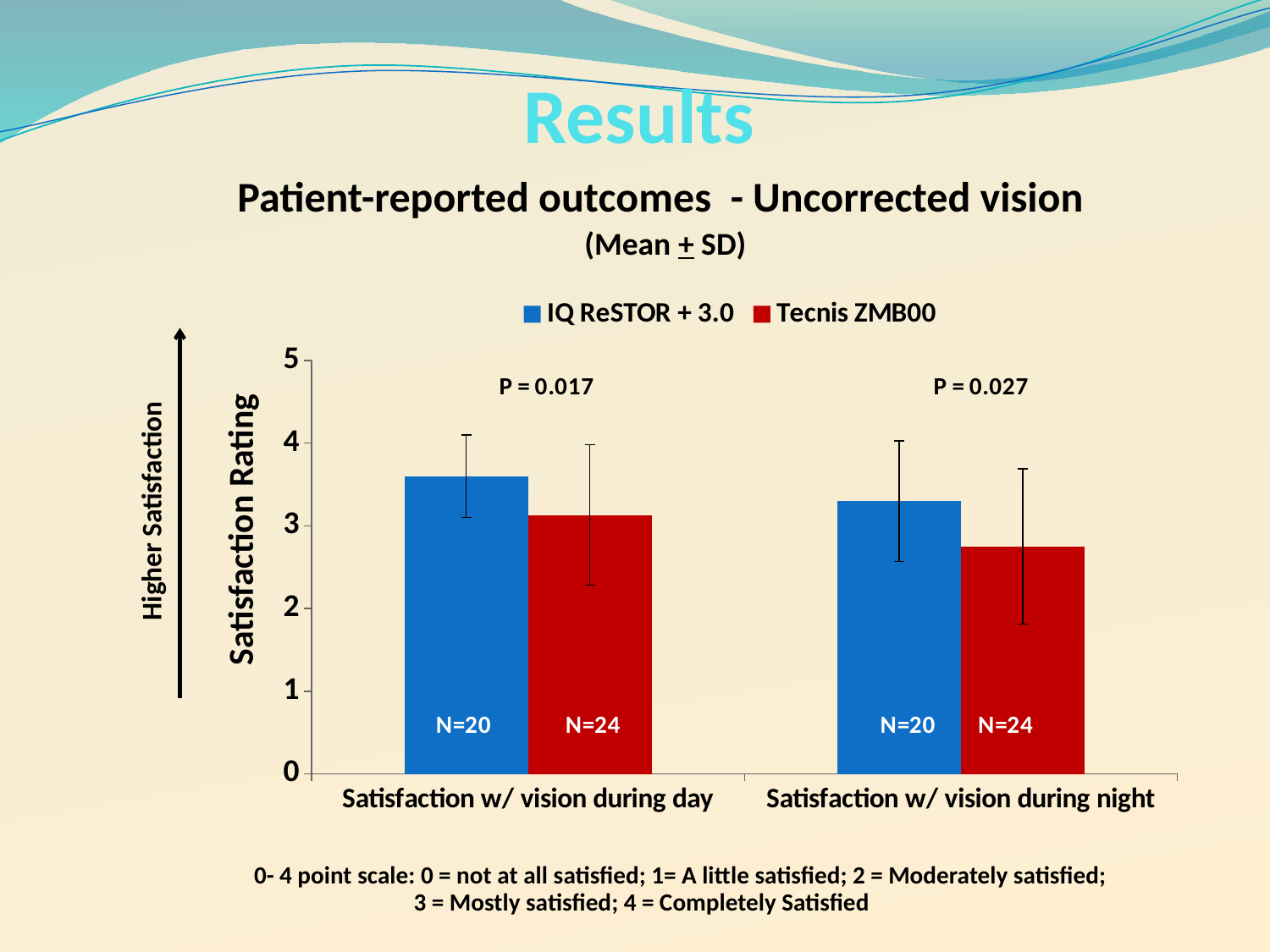
How many categories are shown on the x axis? 2 Which bar is the tallest in the chart? IQ ReSTOR + 3.0, Satisfaction w/ vision during day Is the satisfaction rating for Tecnis ZMB00 during the night greater or less than 3? less How many series does the legend list? 2 What P value is shown above the bars for satisfaction with vision during the night? P = 0.027 Is the satisfaction rating for Tecnis ZMB00 during the day greater or less than 4? less Which series has the higher satisfaction rating for vision during the day? IQ ReSTOR + 3.0 Which bar is the shortest in the chart? Tecnis ZMB00, Satisfaction w/ vision during night Is the satisfaction rating for IQ ReSTOR + 3.0 during the day greater or less than 3? greater What is the label on the y axis of the chart? Satisfaction Rating Which series has the higher satisfaction rating for vision during the night? IQ ReSTOR + 3.0 What kind of chart is shown on the slide? bar chart